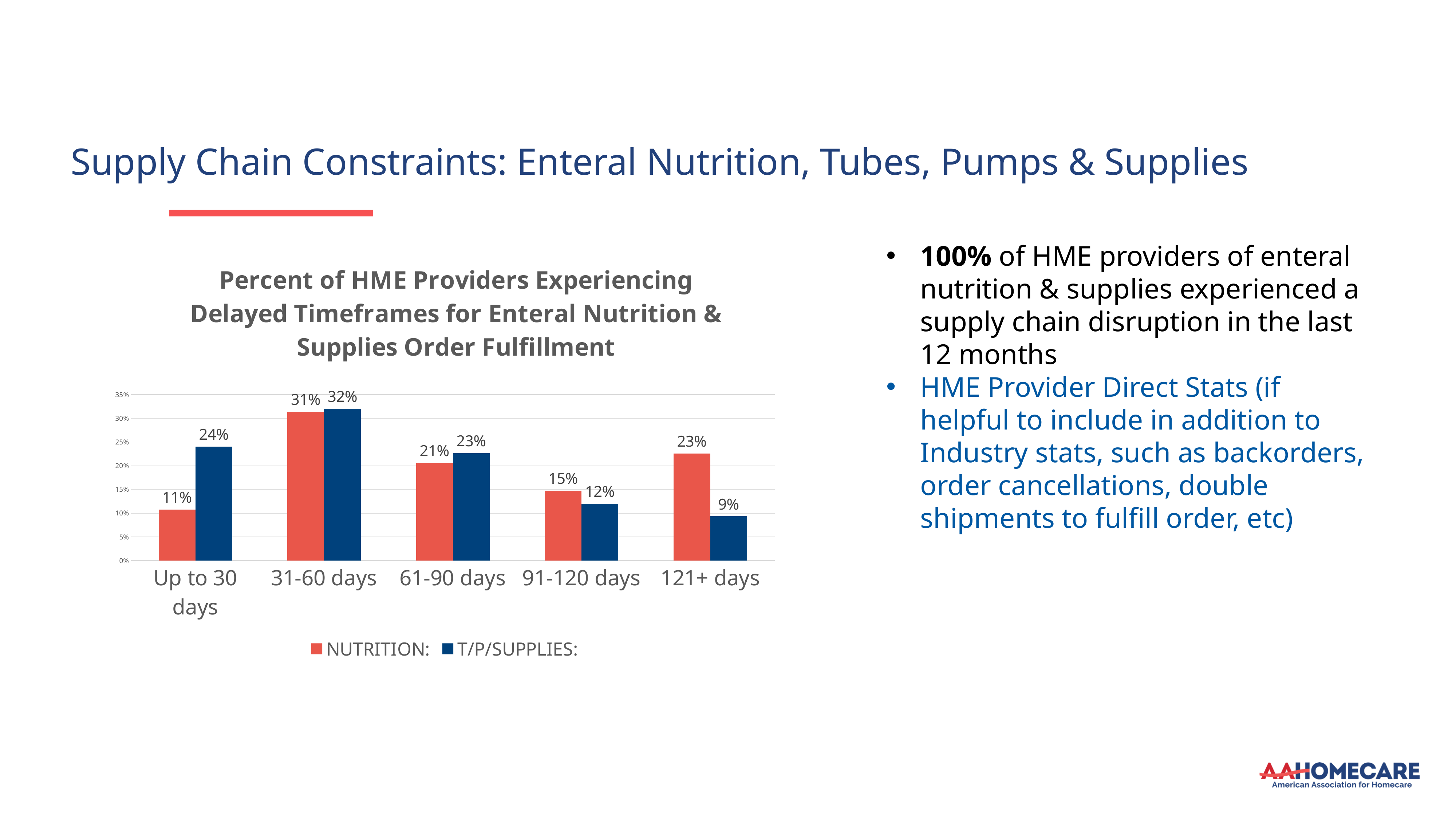
What is the difference between the NUTRITION and T/P/SUPPLIES values for Up to 30 days? 13% What is the T/P/SUPPLIES value for Up to 30 days? 24% For 121+ days, which series has the larger value, NUTRITION or T/P/SUPPLIES? NUTRITION Which category has the highest NUTRITION value? 31-60 days Which category has the lowest T/P/SUPPLIES value? 121+ days How many series does the legend list? 2 What is the T/P/SUPPLIES value for 121+ days? 9% What is the NUTRITION value for 31-60 days? 31% How many delay timeframe categories are shown on the x axis? 5 What is the difference between the NUTRITION values for 31-60 days and 91-120 days? 16% Which colour represents the T/P/SUPPLIES series in the chart? Dark blue What kind of chart is shown on the slide? Bar chart